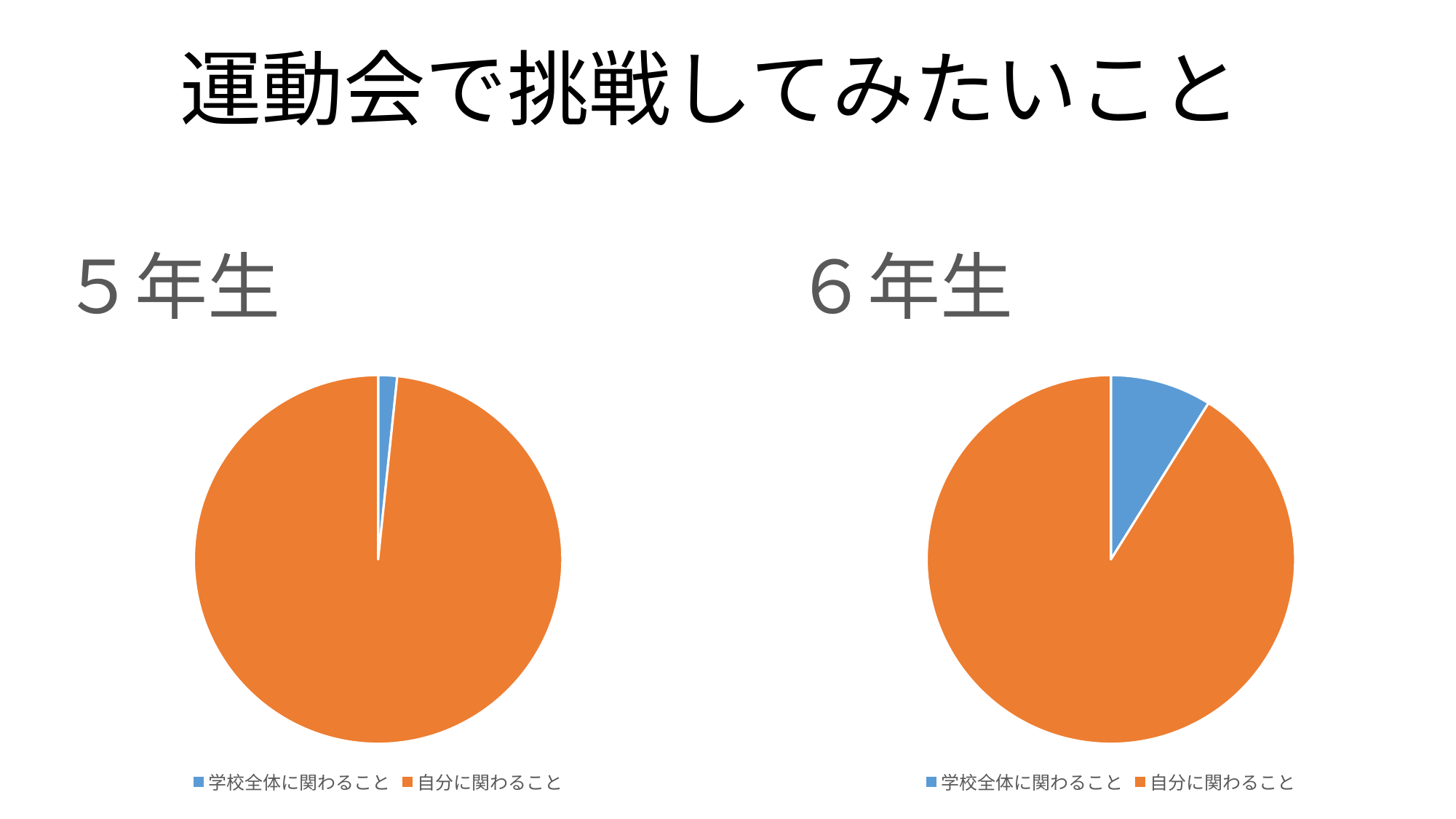
What kind of chart is the 6年生 chart? pie chart What is the title of the slide? 運動会で挑戦してみたいこと In the 5年生 chart, what colour is the slice for 学校全体に関わること? blue What kind of chart is the 5年生 chart? pie chart In the 5年生 chart, which category has the largest slice? 自分に関わること In the 6年生 chart, how many categories does the legend list? 2 In the 6年生 chart, which category has the largest slice? 自分に関わること In the 5年生 chart, how many slices does the pie have? 2 Which chart has the larger slice for 学校全体に関わること, the 5年生 chart or the 6年生 chart? 6年生 In the 6年生 chart, which category has the smallest slice? 学校全体に関わること In the 6年生 chart, which is larger, the slice for 学校全体に関わること or the slice for 自分に関わること? 自分に関わること In the 5年生 chart, which category has the smallest slice? 学校全体に関わること